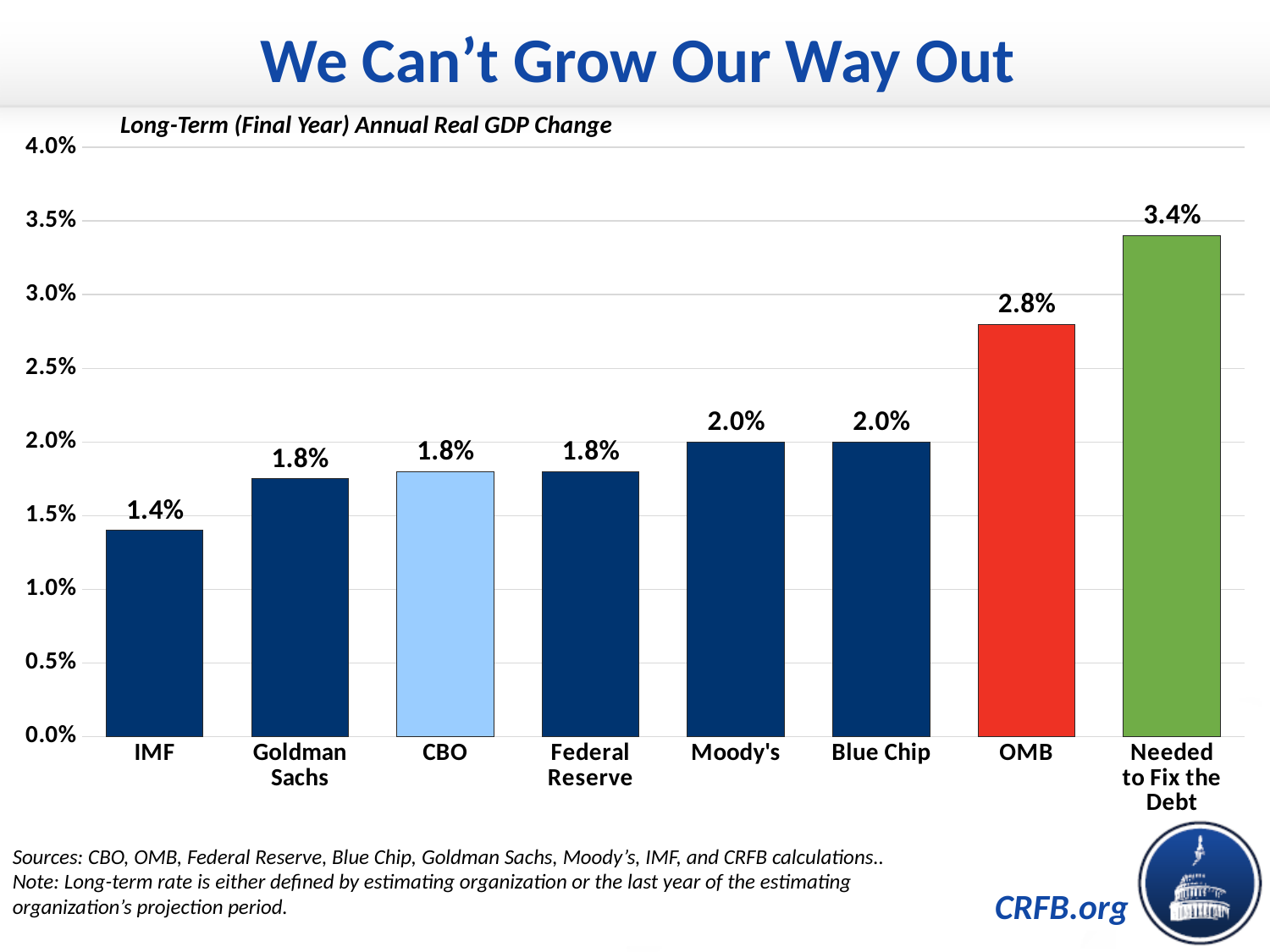
How many categories are shown on the x axis? 8 What is the value for IMF? 1.4% Which is larger, the value for OMB or the value for Blue Chip? OMB What is the value for Moody's? 2.0% What is the value for OMB? 2.8% Is the value for Federal Reserve greater or less than 2.0%? less What is the value for Needed to Fix the Debt? 3.4% Which category has the lowest value? IMF What is the difference between the value for Needed to Fix the Debt and the value for OMB? 0.6% What kind of chart is shown on the slide? bar chart Which category has the highest value? Needed to Fix the Debt What is the subtitle of the chart? Long-Term (Final Year) Annual Real GDP Change